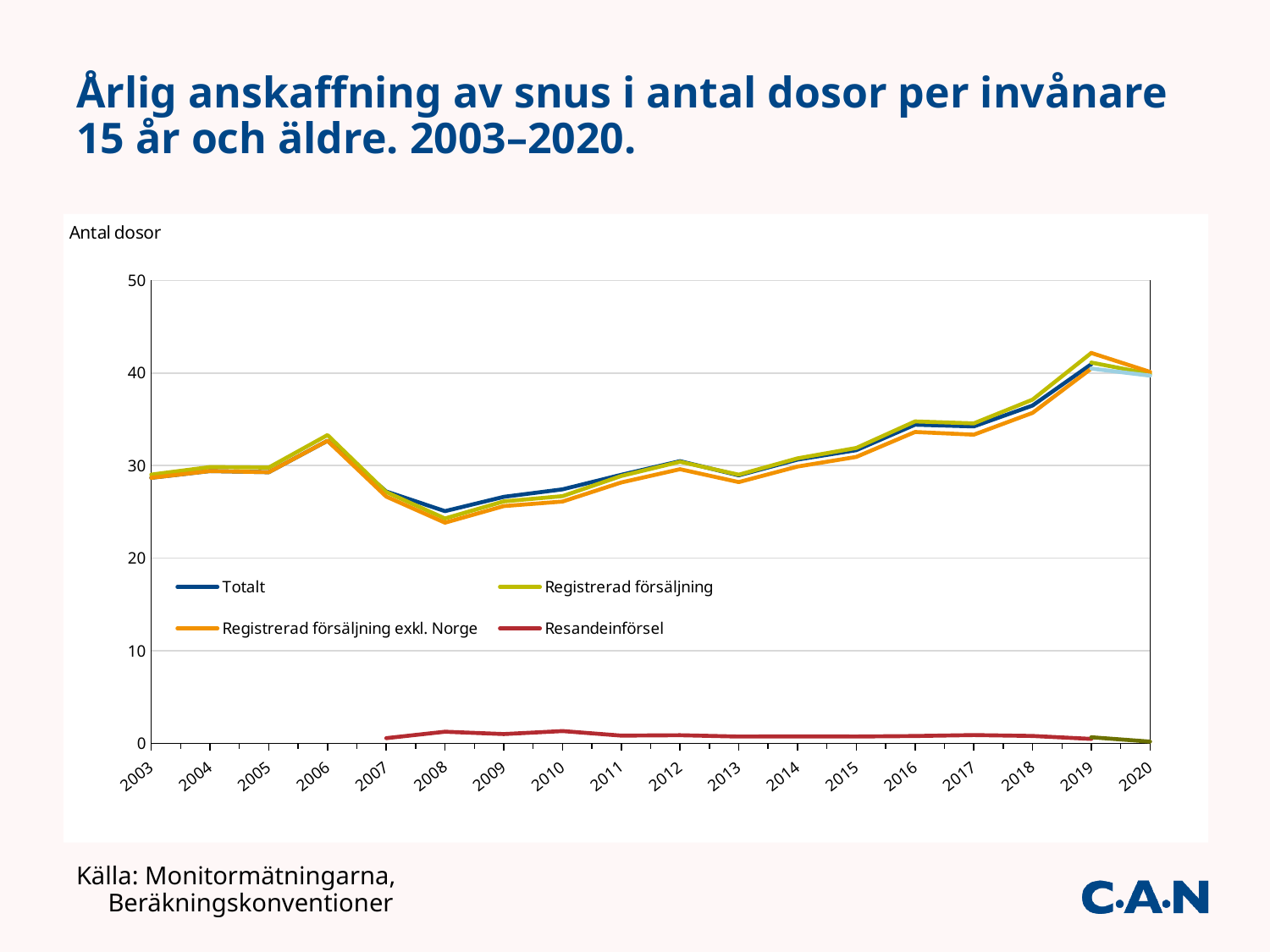
Is the value for Resandeinförsel in 2010 greater or less than 10? less What kind of chart is shown on the slide? line chart In which year is the Totalt series at its lowest? 2008 Which is larger in 2010, Totalt or Resandeinförsel? Totalt What is the label on the y axis? Antal dosor How many series does the legend list? 4 Is the value for Totalt in 2016 greater or less than 30? greater How many years are shown along the x axis? 18 Is the value for Totalt in 2008 greater or less than 30? less Does the Totalt series rise or fall between 2008 and 2019? rise In which year is the Registrerad försäljning series at its highest? 2019